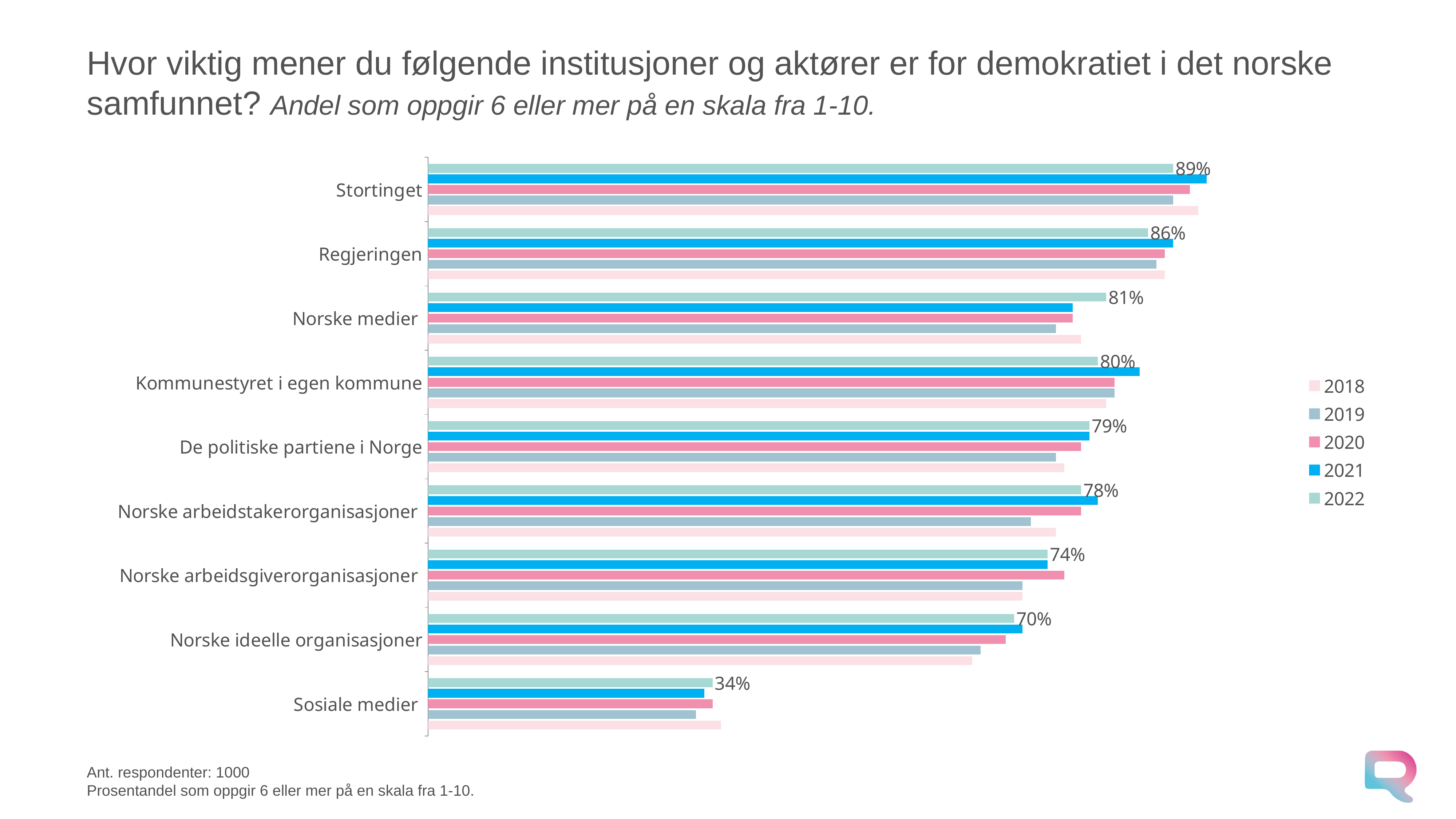
What is the 2022 value for Sosiale medier? 34% Which category has the highest 2022 value? Stortinget How many series does the legend list? 5 What is the difference between the 2022 values for Regjeringen and Norske medier? 5 percentage points What is the difference between the 2022 values for Stortinget and Sosiale medier? 55 percentage points Which has the larger 2022 value, Norske ideelle organisasjoner or Norske arbeidsgiverorganisasjoner? Norske arbeidsgiverorganisasjoner Which category has the lowest 2022 value? Sosiale medier What is the 2022 value for Kommunestyret i egen kommune? 80% What is the 2022 value for Norske arbeidsgiverorganisasjoner? 74% How many categories (institutions and actors) are shown on the chart? 9 What is the 2022 value for Stortinget? 89% For Norske ideelle organisasjoner, which year has the longer bar, 2018 or 2022? 2022